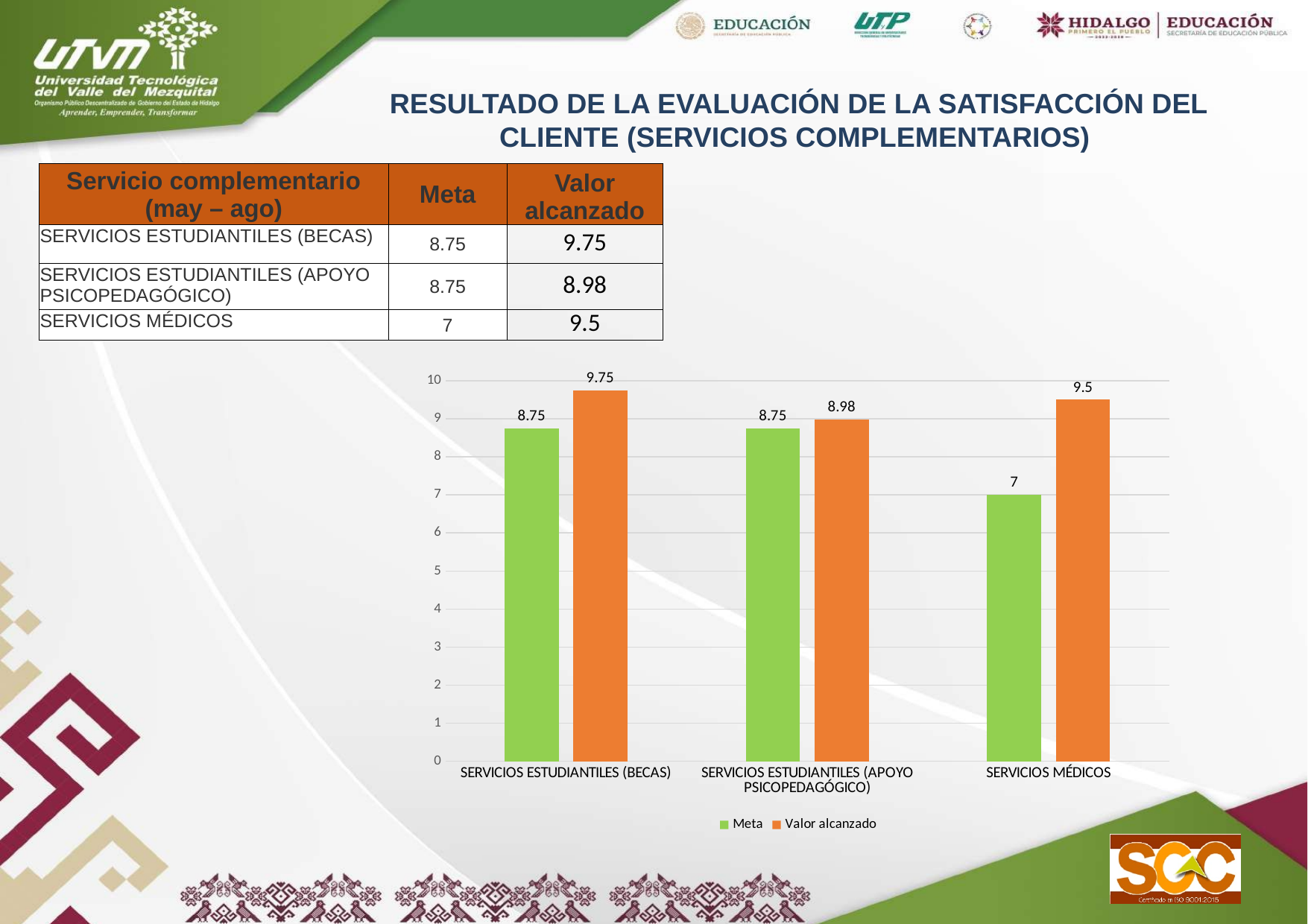
Which category has the highest Valor alcanzado? SERVICIOS ESTUDIANTILES (BECAS) What kind of chart is shown on the slide? Bar chart Which category has the lowest Meta? SERVICIOS MÉDICOS What is the Meta for SERVICIOS MÉDICOS? 7 What is the difference between the Valor alcanzado and the Meta for SERVICIOS MÉDICOS? 2.5 How many categories are shown on the x axis of the chart? 3 Which is larger for SERVICIOS ESTUDIANTILES (APOYO PSICOPEDAGÓGICO): the Meta or the Valor alcanzado? Valor alcanzado What is the Valor alcanzado for SERVICIOS ESTUDIANTILES (BECAS)? 9.75 Is the Valor alcanzado for SERVICIOS MÉDICOS greater or less than 9? greater What is the Valor alcanzado for SERVICIOS ESTUDIANTILES (APOYO PSICOPEDAGÓGICO)? 8.98 What is the difference between the Valor alcanzado and the Meta for SERVICIOS ESTUDIANTILES (BECAS)? 1 How many series does the chart legend list? 2